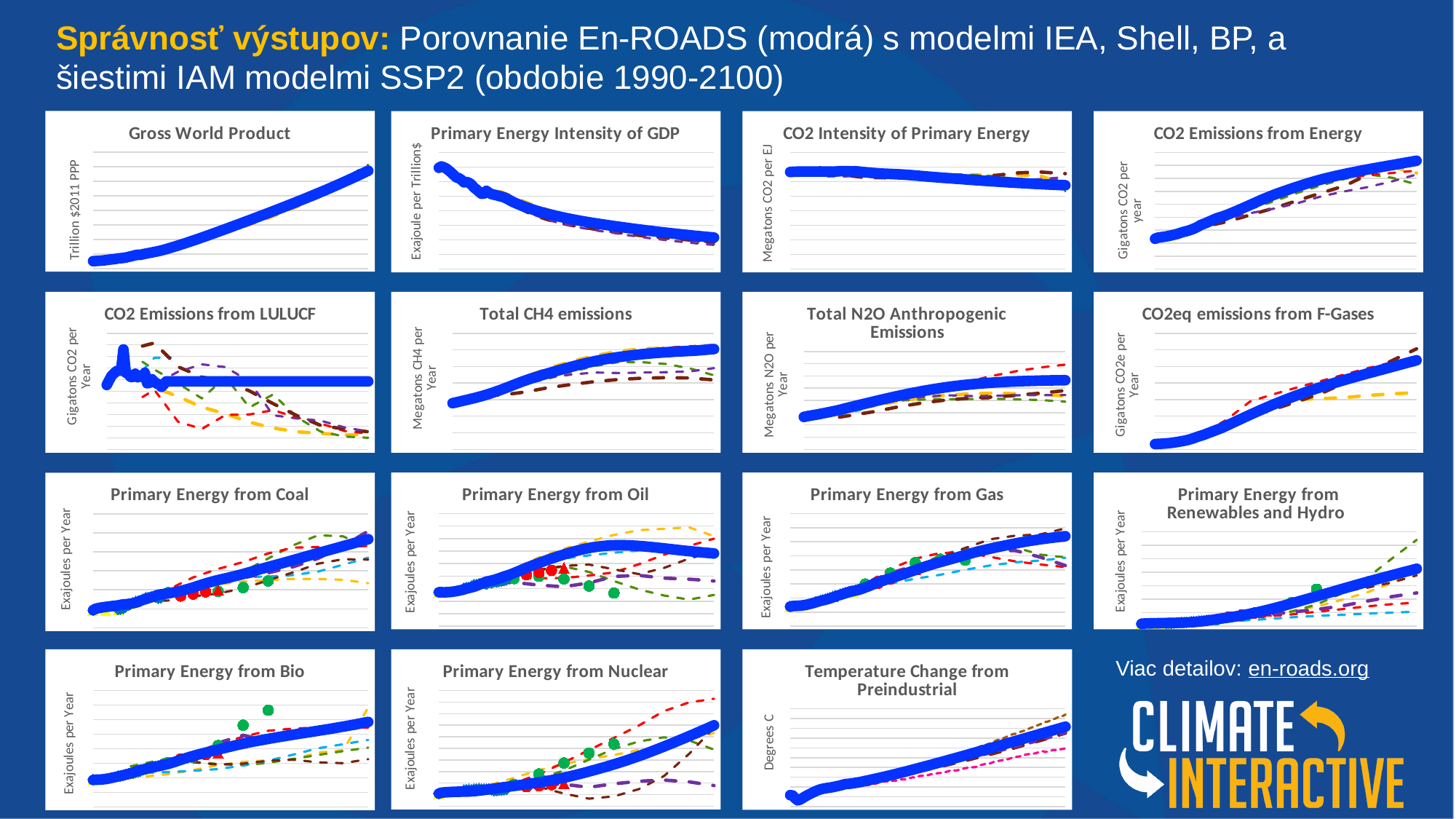
What is the y-axis label of the "Gross World Product" chart? Trillion $2011 PPP In the "CO2 Emissions from Energy" chart, does the thick blue line rise or fall from left to right? rise In the "Primary Energy from Renewables and Hydro" chart, does the thick blue line rise or fall over the period? rise In the "Primary Energy Intensity of GDP" chart, does the thick blue line rise or fall over the period? fall What is the y-axis label of the "Temperature Change from Preindustrial" chart? Degrees C What kind of chart is the "Gross World Product" chart? line chart